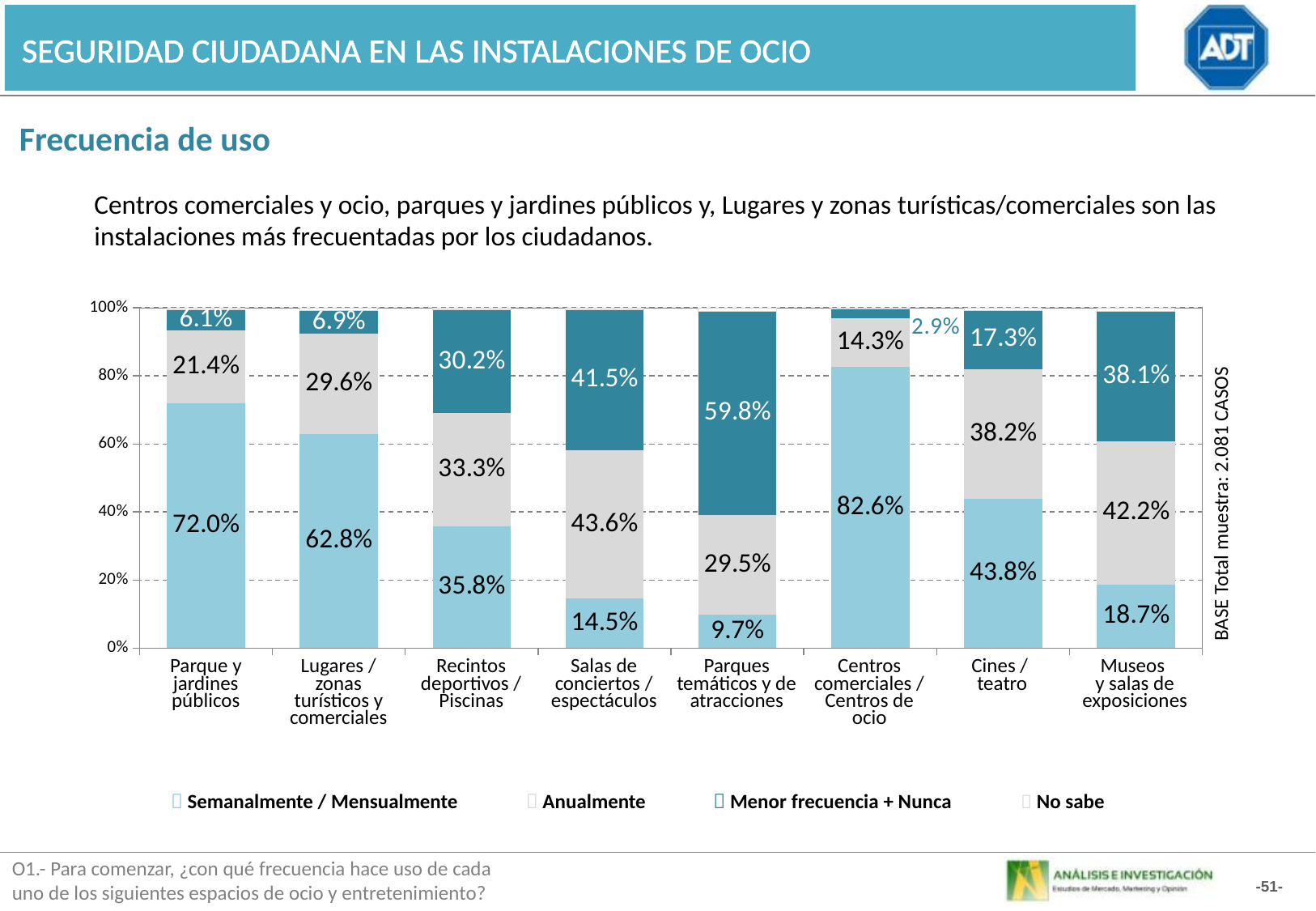
Which category has the highest 'Semanalmente / Mensualmente' value? Centros comerciales / Centros de ocio How many series does the legend list? 4 What is the base (total sample) stated next to the chart? 2.081 CASOS What is the 'Menor frecuencia + Nunca' value for Parques temáticos y de atracciones? 59.8% Which is larger: the 'Anualmente' value for Salas de conciertos / espectáculos or for Cines / teatro? Salas de conciertos / espectáculos How many categories are shown on the x axis of the chart? 8 What is the difference between the 'Semanalmente / Mensualmente' values for Parque y jardines públicos and Lugares / zonas turísticas y comerciales? 9.2% What kind of chart is shown on the slide? Stacked bar chart What percentage of respondents use Centros comerciales / Centros de ocio semanalmente / mensualmente? 82.6% Is the 'Semanalmente / Mensualmente' value for Recintos deportivos / Piscinas greater or less than 40%? less What is the 'Anualmente' value for Museos y salas de exposiciones? 42.2% Which category has the lowest 'Semanalmente / Mensualmente' value? Parques temáticos y de atracciones